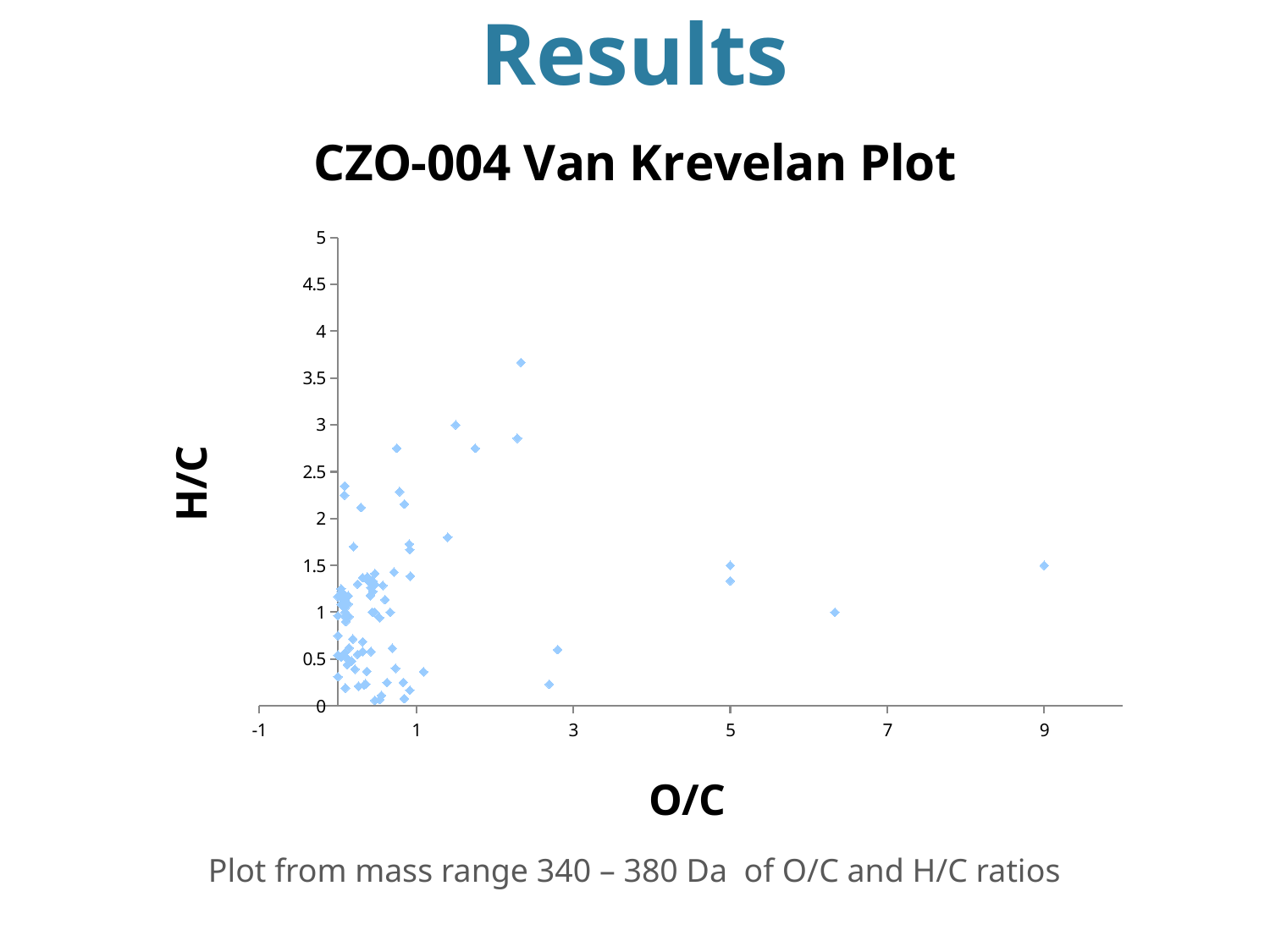
Which has the higher H/C value: the point at O/C 9 or the point at O/C 6.3? The point at O/C 9 What kind of chart is shown on the slide? Scatter plot Is the highest H/C value plotted greater or less than 3? greater What is the label of the x axis? O/C Is the H/C value of the rightmost point (at O/C 9) greater or less than 1? greater How many points have an O/C value greater than 3? 4 What is the O/C value of the rightmost point on the chart? 9 What is the title of the chart? CZO-004 Van Krevelan Plot Is the H/C value of the point at O/C 6.3 greater or less than 2? less What is the maximum value shown on the H/C axis? 5